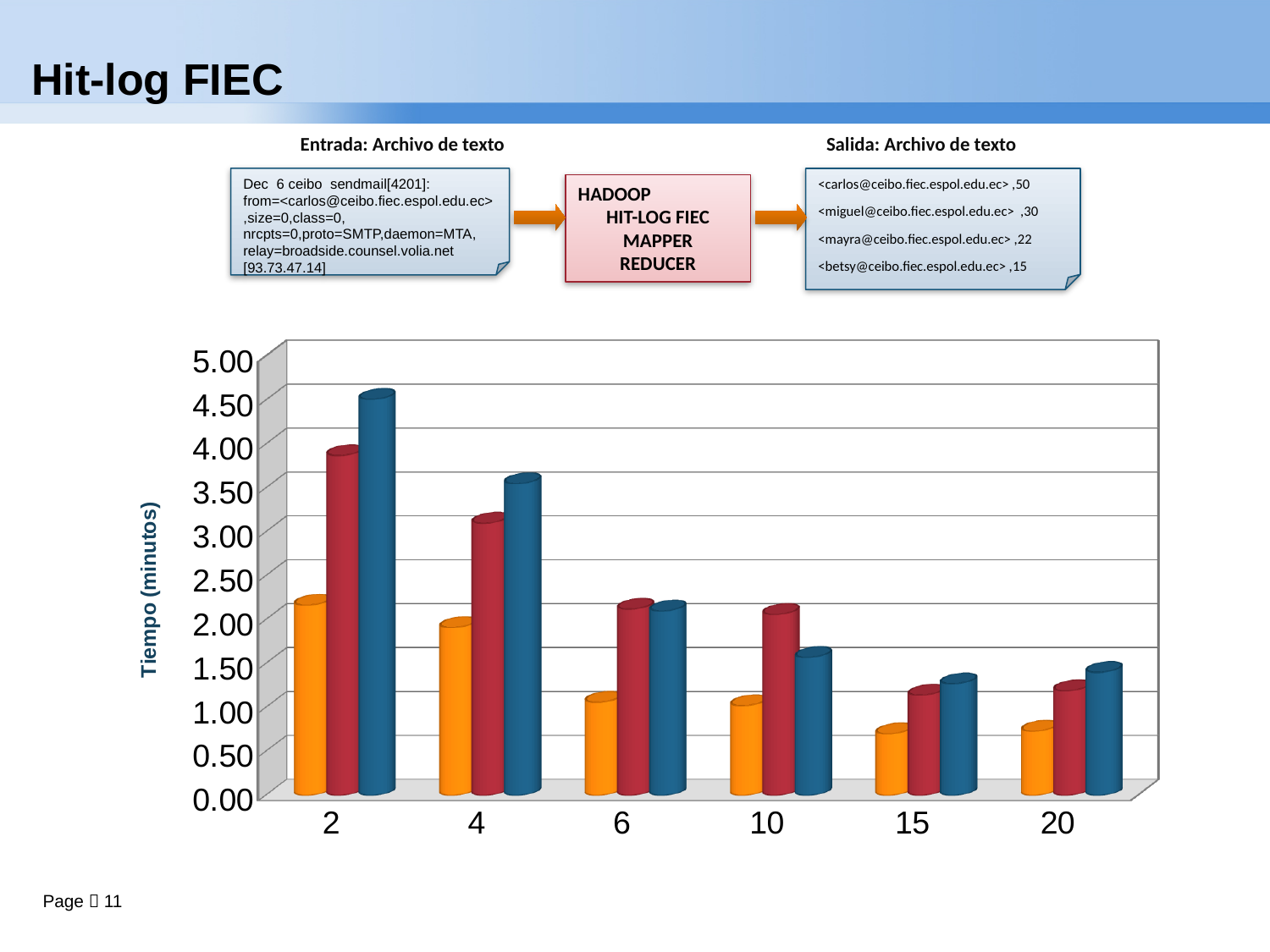
Which is larger: the blue bar for category 2 or the blue bar for category 4? the blue bar for category 2 Is the value of the blue bar for category 2 greater or less than 4.00? greater Is the value of the red bar for category 4 greater or less than 2.50? greater Is the value of the orange bar for category 15 greater or less than 1.00? less How many categories are shown on the x axis of the chart? 6 What is the title of the vertical axis of the chart? Tiempo (minutos) Which category has the tallest bar in the chart? 2 How many bars are plotted for each category on the x axis? 3 Do the orange bars generally rise or fall as the x-axis values increase from 2 to 20? fall What kind of chart is shown on the slide? bar chart